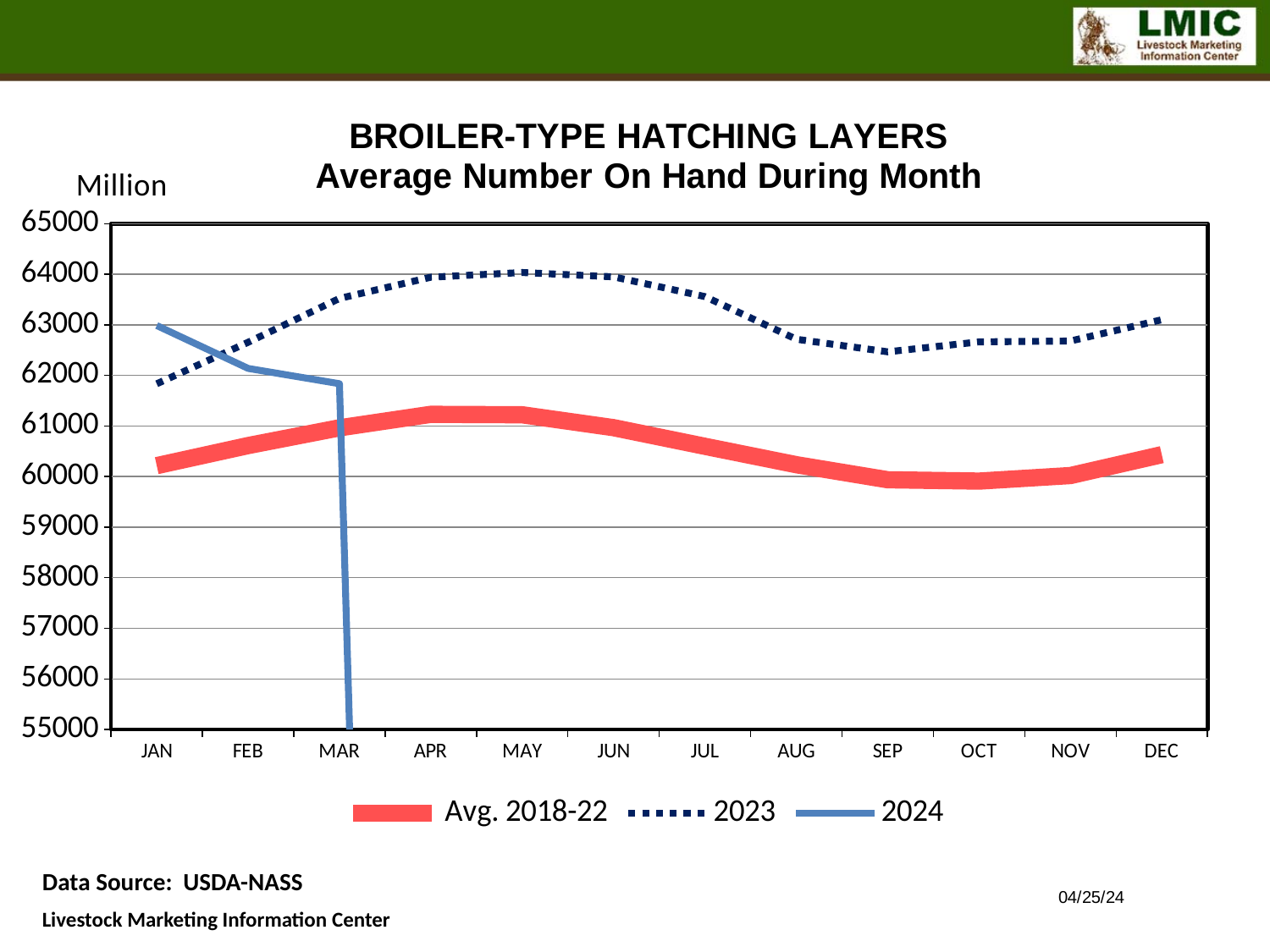
What unit label is shown above the y axis? Million Which series is drawn as a dotted line? 2023 Does the 2024 series rise or fall from JAN to MAR? fall How many series does the legend list? 3 Is the 2023 value for MAY greater or less than 63000? greater In JAN, which series is larger: 2024 or 2023? 2024 Is the Avg. 2018-22 value for JAN greater or less than 60000? greater In MAR, which series is larger: 2023 or 2024? 2023 Is the 2023 value for JAN greater or less than 62000? less What kind of chart is shown on the slide? line chart How many months are shown along the x axis? 12 In MAY, which series is larger: 2023 or Avg. 2018-22? 2023